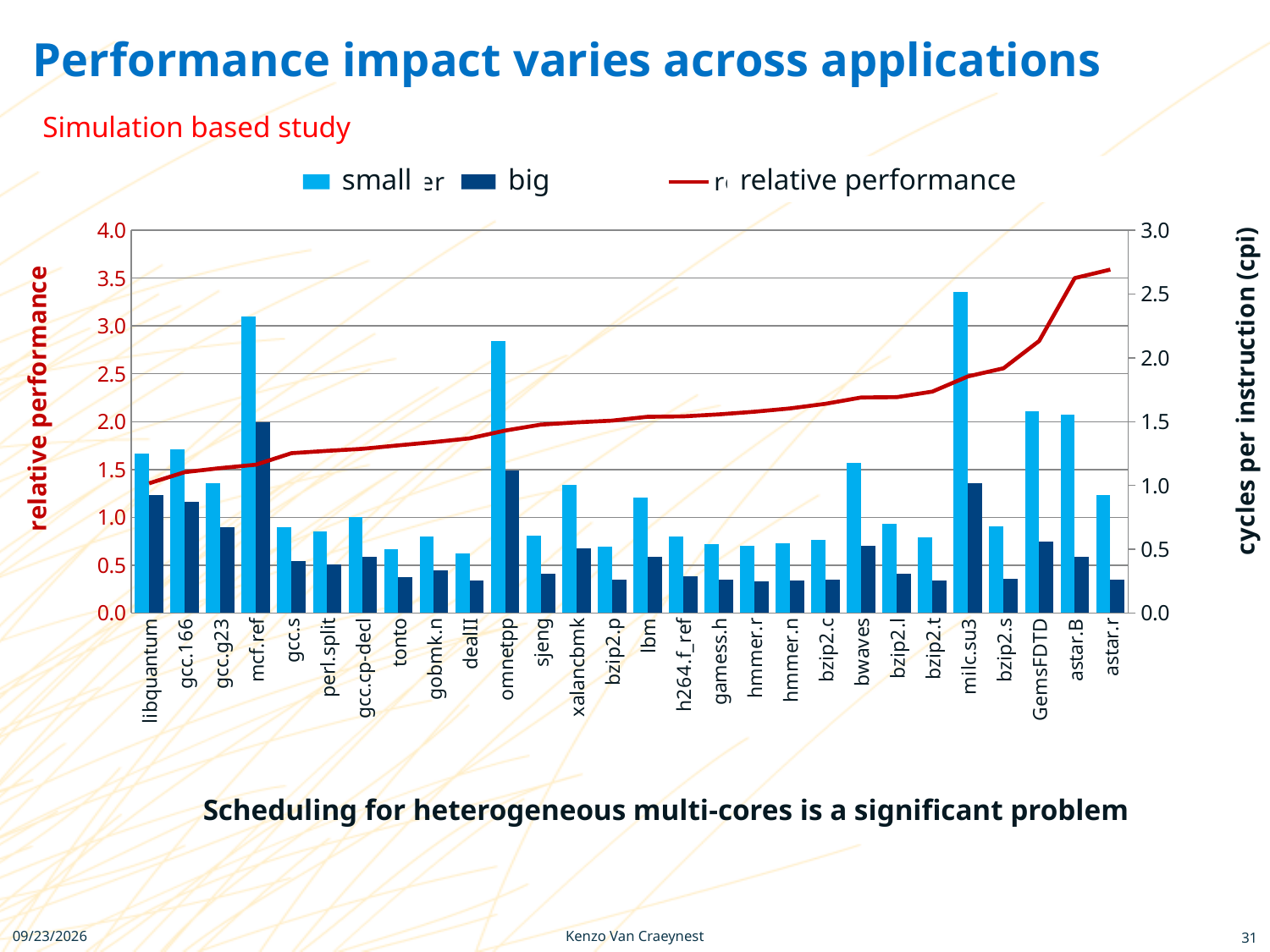
Which application has the highest 'big' bar? mcf.ref Does the 'relative performance' line rise or fall from left to right along the x axis? Rises Is the 'small' value for tonto greater or less than 1.0? less Which application has the highest 'small' bar? milc.su3 What kind of chart is shown on the slide? A bar chart with a line overlay How many series does the legend list? 3 What is the label of the right vertical axis? cycles per instruction (cpi) For omnetpp, which is larger, the 'small' bar or the 'big' bar? small What is the label of the left vertical axis? relative performance How many applications (categories) are plotted along the x axis? 28